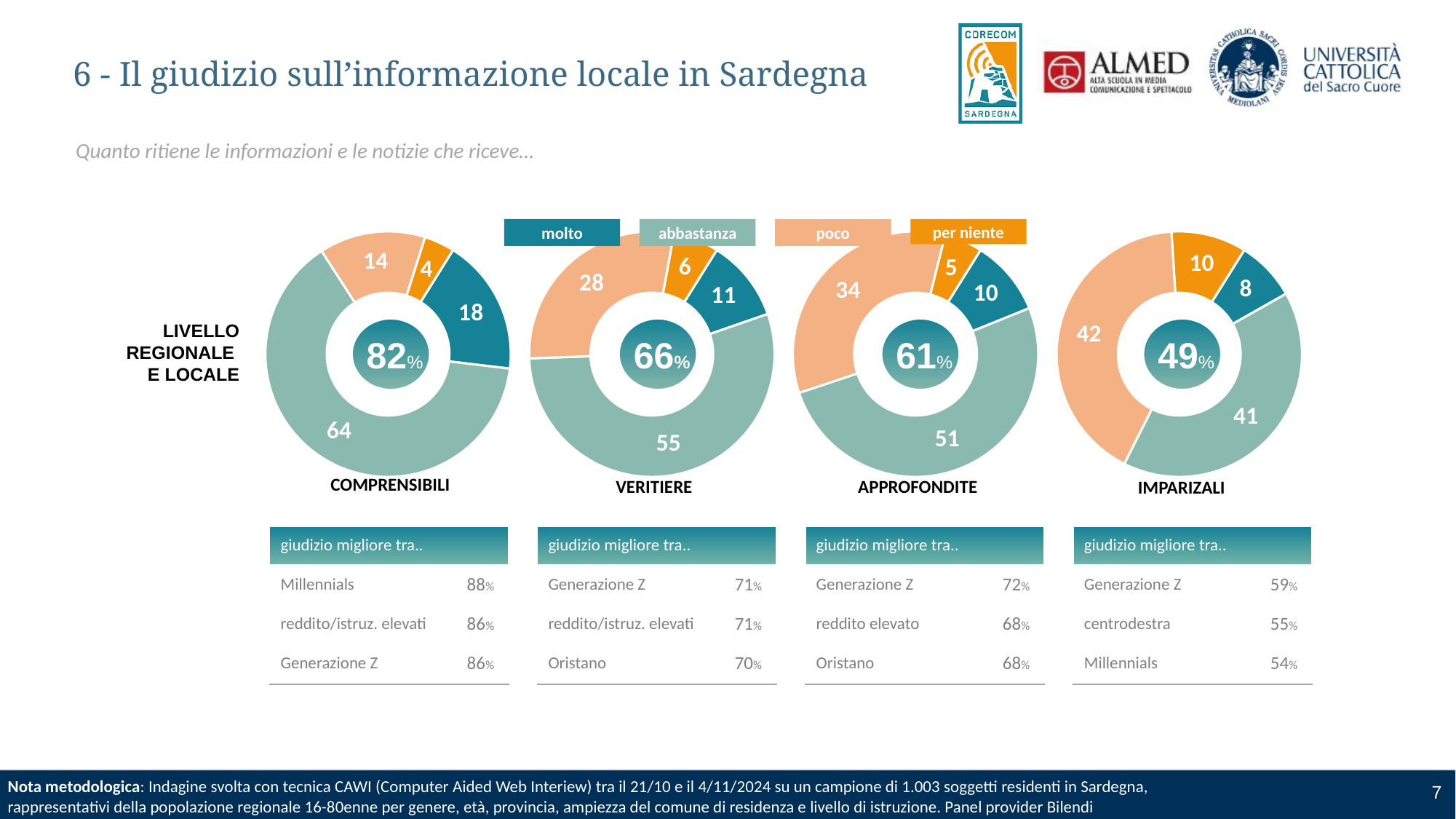
In the IMPARZIALI donut chart, what is the difference between the 'poco' and 'abbastanza' values? 1 What percentage is shown in the centre of the VERITIERE donut chart? 66% In the APPROFONDITE donut chart, which slice is the smallest? per niente In the VERITIERE donut chart, which is larger: the 'molto' slice or the 'poco' slice? poco In the APPROFONDITE donut chart, what value is shown for the 'molto' slice? 10 In the VERITIERE donut chart, what value is shown for the 'poco' slice? 28 In the COMPRENSIBILI donut chart, what value is shown for the 'abbastanza' slice? 64 How many categories does the legend above the donut charts list? 4 In the COMPRENSIBILI donut chart, which slice is the largest? abbastanza What type of chart is used for COMPRENSIBILI, VERITIERE, APPROFONDITE and IMPARZIALI? Donut (pie) chart In the IMPARZIALI donut chart, what value is shown for the 'per niente' slice? 10 How many slices does each donut chart on the slide have? 4